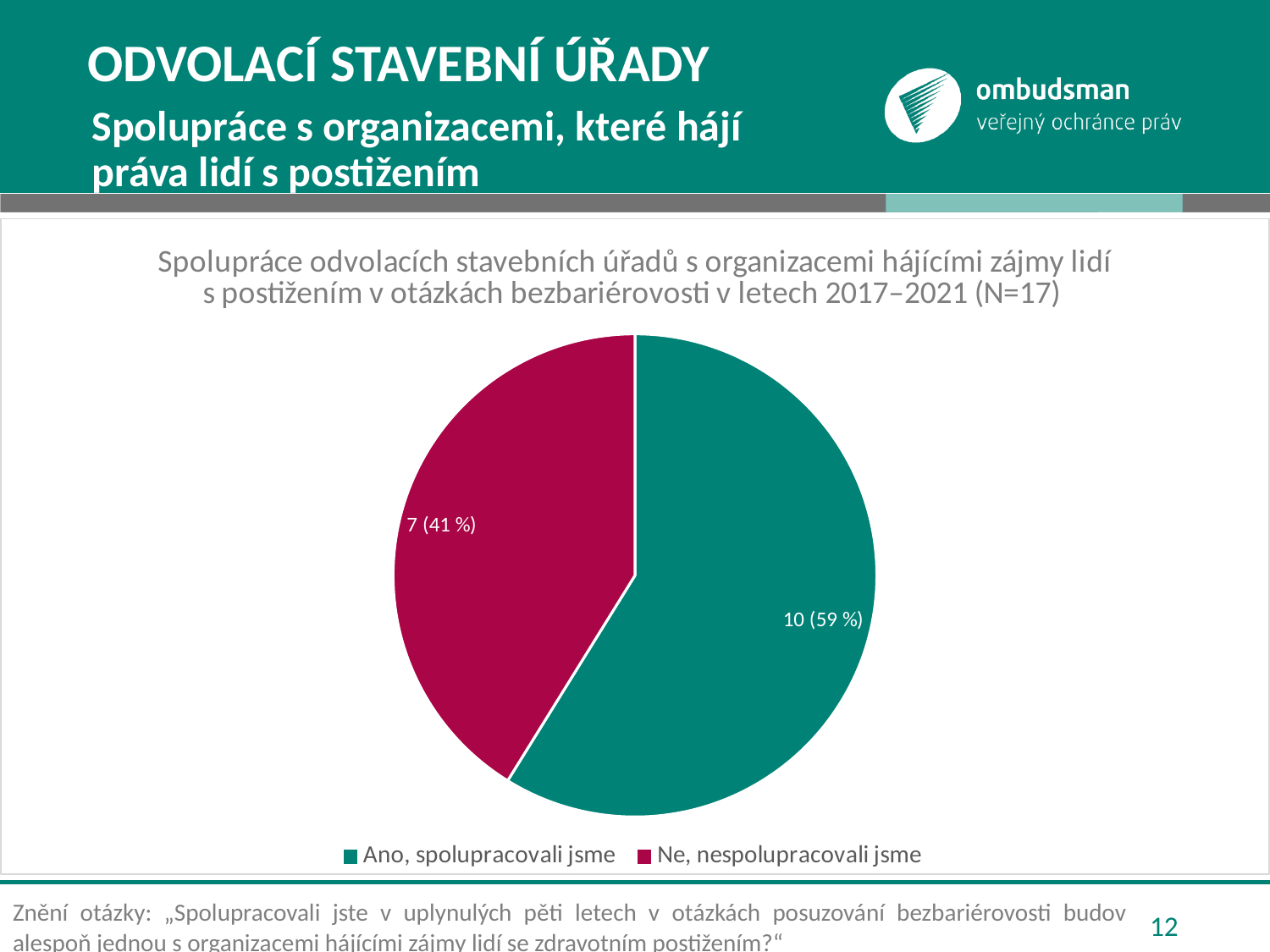
What kind of chart is shown on the slide? pie chart What is the difference in count between "Ano, spolupracovali jsme" and "Ne, nespolupracovali jsme"? 3 Which category has the largest slice? Ano, spolupracovali jsme What is the total number of responses (N) stated in the chart title? 17 How many slices does the pie chart have? 2 What share of the pie does "Ne, nespolupracovali jsme" represent? 41 % Which category has the smallest slice? Ne, nespolupracovali jsme What is the value shown for "Ne, nespolupracovali jsme"? 7 (41 %) Which is larger: "Ano, spolupracovali jsme" or "Ne, nespolupracovali jsme"? Ano, spolupracovali jsme What colour is the slice for "Ne, nespolupracovali jsme"? dark red (magenta) How many entries does the legend list? 2 What is the value shown for "Ano, spolupracovali jsme"? 10 (59 %)